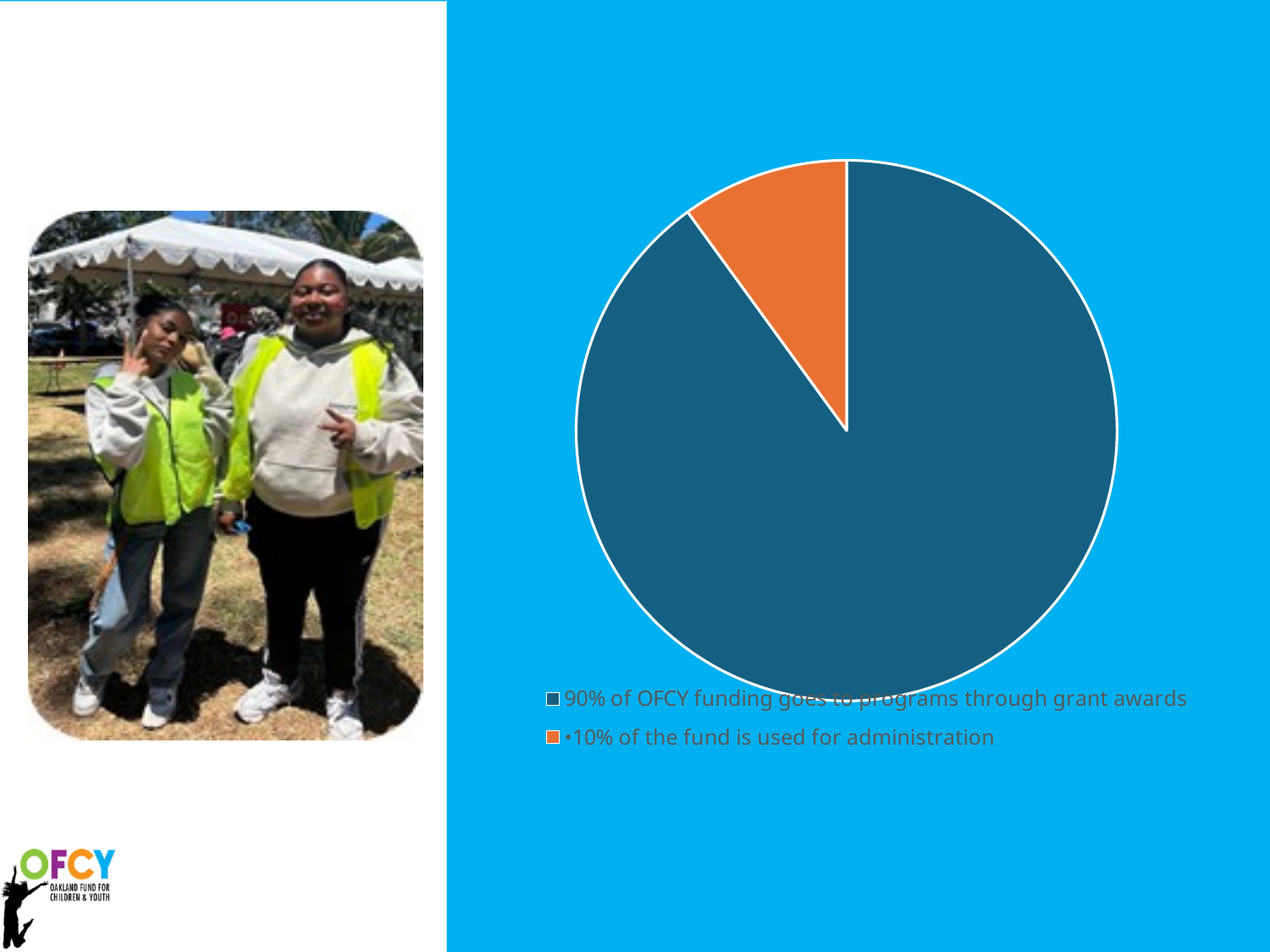
What share of OFCY funding goes to programs through grant awards, according to the pie chart? 90% What colour is the slice representing the 10% used for administration? orange How many slices does the pie chart have? 2 How many entries does the legend of the pie chart list? 2 What share of the fund is used for administration, according to the pie chart? 10% Which is larger in the pie chart: the share for programs through grant awards or the share for administration? programs through grant awards What colour is the slice representing the 90% of funding that goes to programs through grant awards? dark blue Which slice of the pie chart is the smallest? 10% of the fund is used for administration Which slice of the pie chart is the largest? 90% of OFCY funding goes to programs through grant awards What kind of chart is shown on the slide? pie chart What is the difference between the share for programs through grant awards and the share for administration? 80%